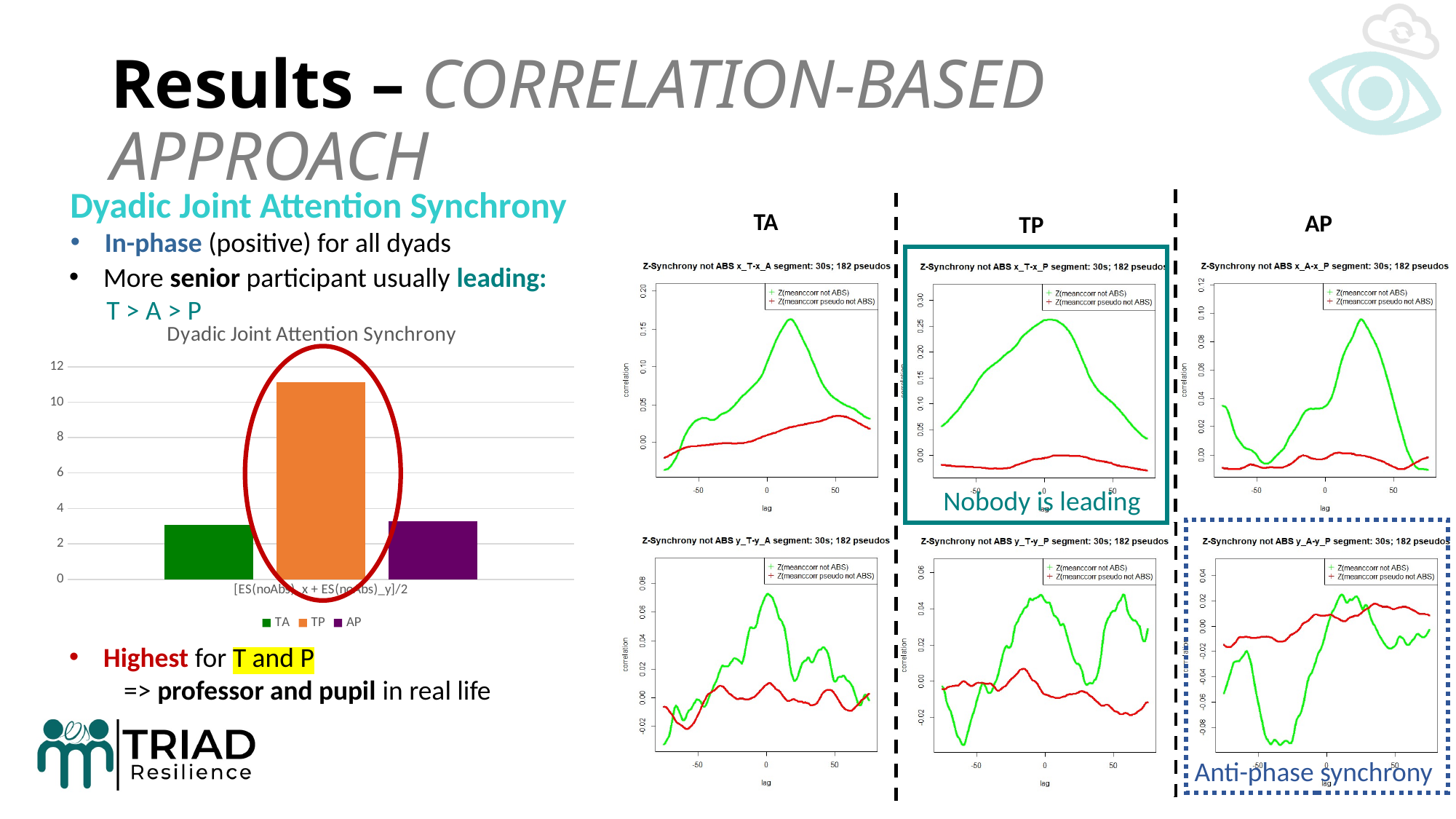
In the 'Dyadic Joint Attention Synchrony' bar chart, is the value for TA greater or less than 4? less What is the title of the bar chart on the left of the slide? Dyadic Joint Attention Synchrony How many series does the legend list in the top-left line chart titled 'Z-Synchrony not ABS x_T-x_A segment: 30s; 182 pseudos'? 2 How many series does the legend of the 'Dyadic Joint Attention Synchrony' bar chart list? 3 In the 'Dyadic Joint Attention Synchrony' bar chart, which is larger, the value for AP or the value for TP? TP In the 'Dyadic Joint Attention Synchrony' bar chart, which series has the highest bar? TP In the 'Dyadic Joint Attention Synchrony' bar chart, is the value for TP greater or less than 10? greater What kind of chart is the top-left chart in the right-hand panel, titled 'Z-Synchrony not ABS x_T-x_A segment: 30s; 182 pseudos'? line chart What kind of chart is the 'Dyadic Joint Attention Synchrony' chart on the left? bar chart In the 'Dyadic Joint Attention Synchrony' bar chart, is the value for AP greater or less than 2? greater In the 'Dyadic Joint Attention Synchrony' bar chart, what colour is the TP bar? orange In the 'Dyadic Joint Attention Synchrony' bar chart, which is larger, the value for TP or the value for TA? TP